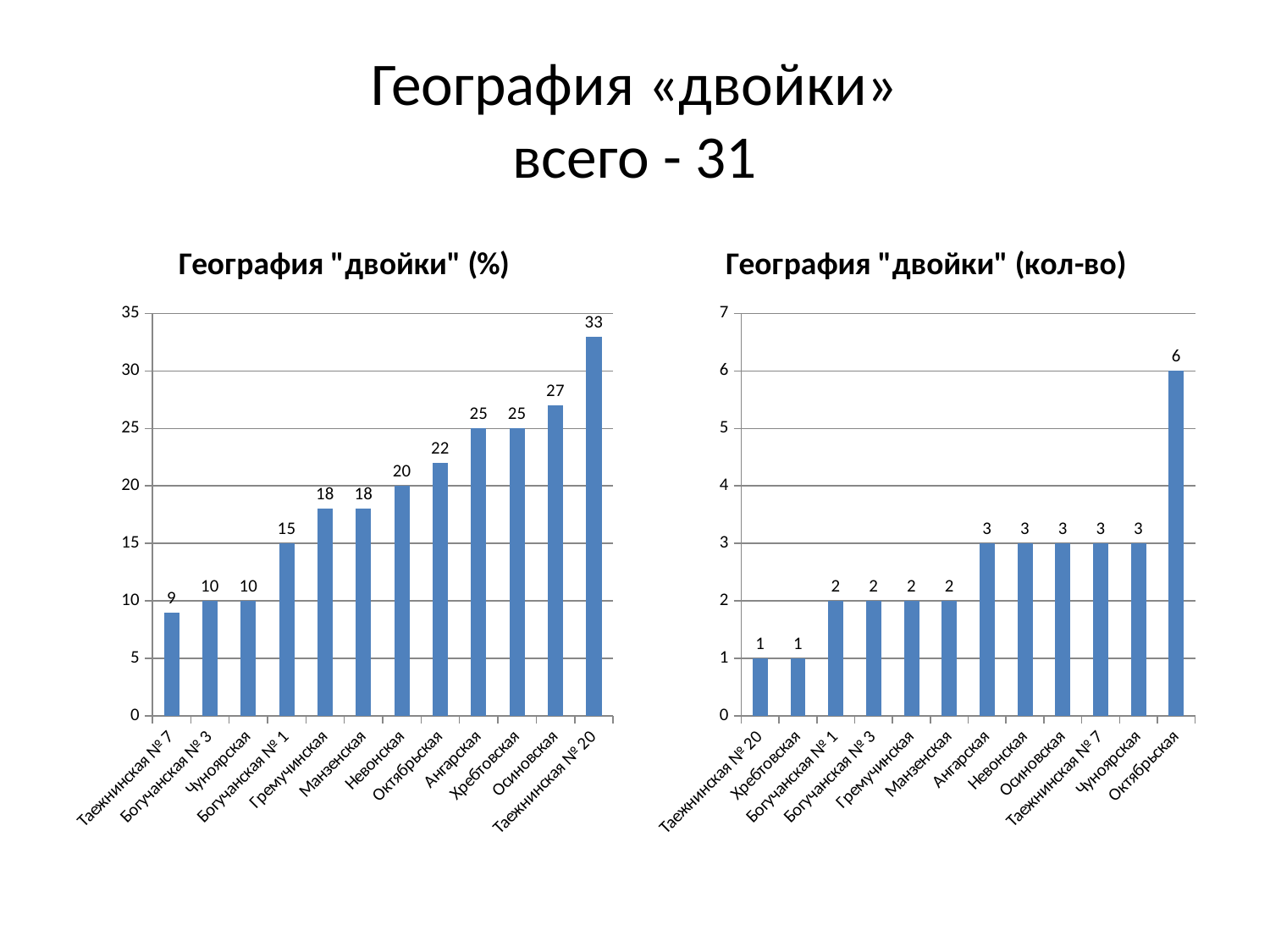
In the chart titled География "двойки" (%), what is the value for Невонская? 20 In the chart titled География "двойки" (%), what is the difference between the values for Осиновская and Богучанская № 1? 12 In the chart titled География "двойки" (%), which category has the highest value? Таежнинская № 20 In the chart titled География "двойки" (%), which category has the lowest value? Таежнинская № 7 In the chart titled География "двойки" (%), do the values rise or fall from left to right? rise In the chart titled География "двойки" (кол-во), what is the value for Октябрьская? 6 What is the title of the chart on the left of the slide? География "двойки" (%) In the chart titled География "двойки" (кол-во), what is the difference between the values for Октябрьская and Манзенская? 4 In the chart titled География "двойки" (%), how many categories are shown? 12 In the chart titled География "двойки" (кол-во), which category has the highest value? Октябрьская What kind of chart is the chart titled География "двойки" (кол-во)? bar chart In the chart titled География "двойки" (кол-во), which is larger, the value for Ангарская or the value for Хребтовская? Ангарская